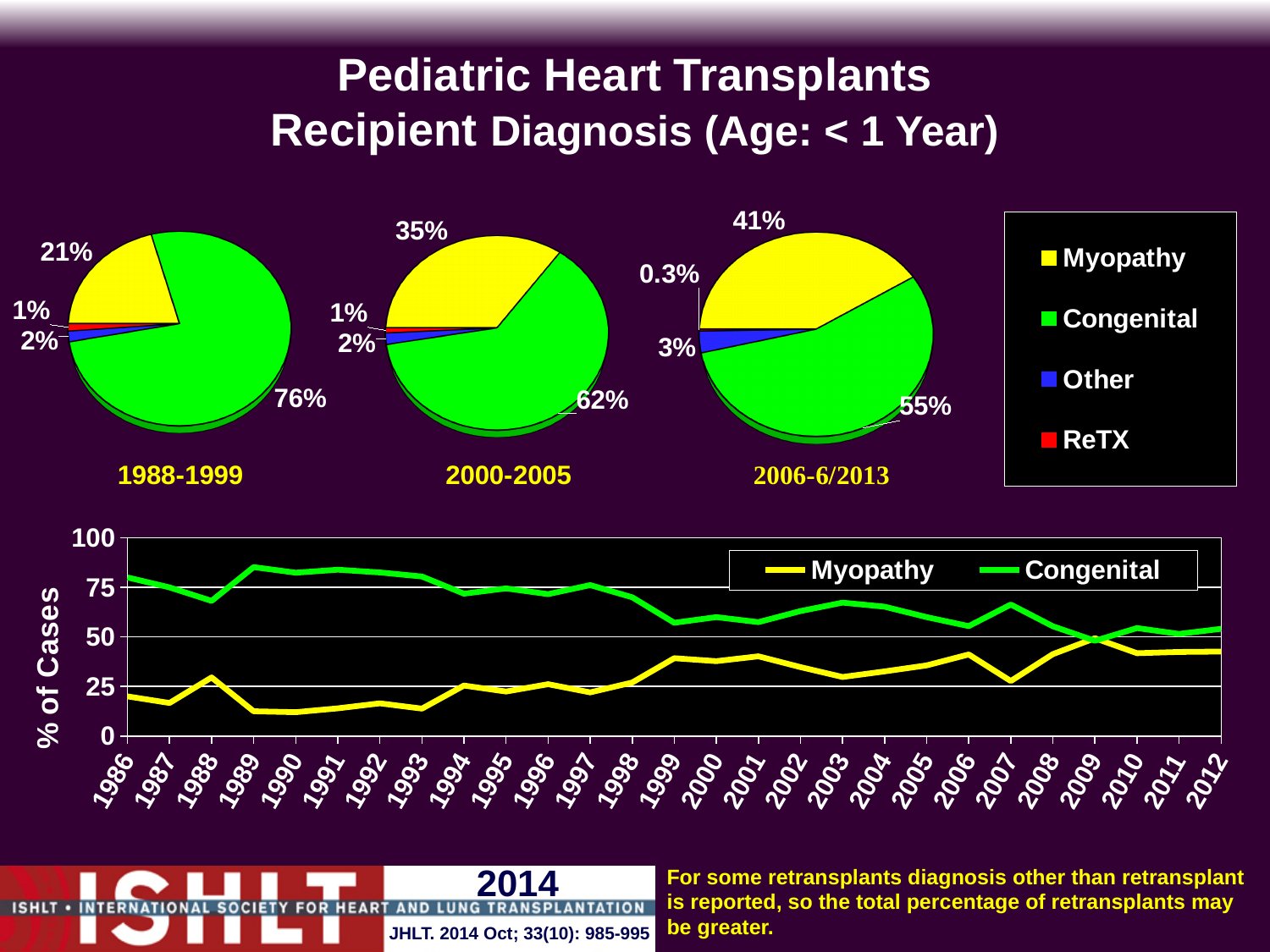
In the bottom line chart, is the value for Congenital in 1986 greater or less than 75? greater In the bottom line chart, is the value for Myopathy in 1989 greater or less than 25? less In the 1988-1999 pie chart, what percentage of cases is Congenital? 76% In the bottom line chart, does the Congenital line generally rise or fall from 1986 to 2012? Fall In the 2000-2005 pie chart, what percentage of cases is Myopathy? 35% In the 2006-6/2013 pie chart, what is the difference between the Congenital and Myopathy percentages? 14% In the 1988-1999 pie chart, which diagnosis has the smallest share? ReTX In the 2006-6/2013 pie chart, which diagnosis has the largest share? Congenital In the 2006-6/2013 pie chart, what percentage of cases is ReTX? 0.3% What kind of chart is the bottom chart showing % of Cases from 1986 to 2012? Line chart Comparing the 1988-1999 and 2006-6/2013 pie charts, which period has the larger Myopathy share? 2006-6/2013 How many series does the legend of the pie charts list? 4